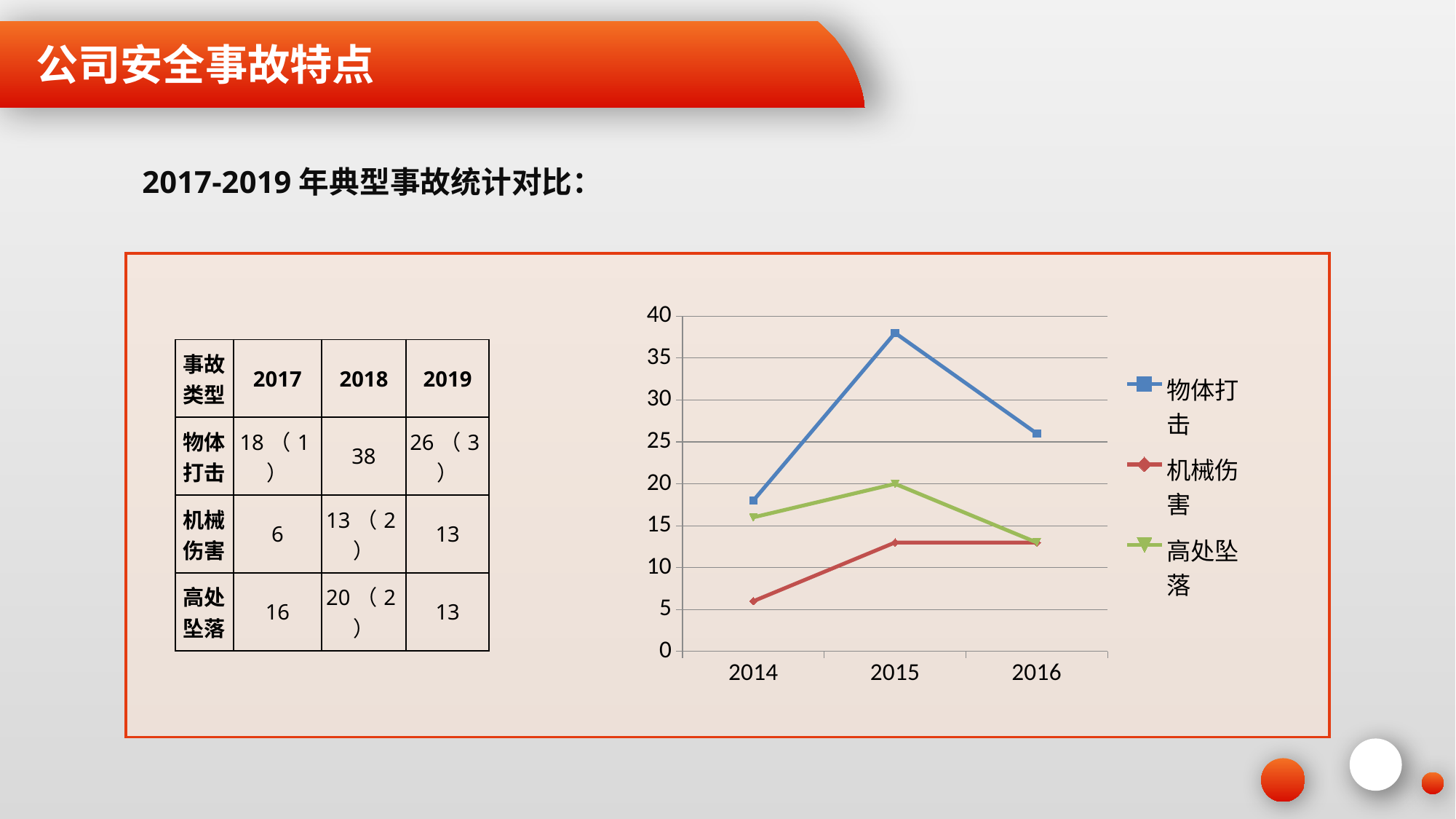
Is the value for 物体打击 in 2015 greater or less than 35? greater How many years are shown on the chart's x axis? 3 What kind of chart is shown on the slide? line chart How many series does the chart's legend list? 3 Which series has the lowest value in 2014? 机械伤害 Which series is drawn with the blue line in the chart? 物体打击 In which year does the 物体打击 series reach its highest value? 2015 Does the 物体打击 series rise or fall from 2015 to 2016? fall Is the value for 机械伤害 in 2014 greater or less than 10? less In which year is the 物体打击 series at its lowest value? 2014 In 2015, which series has the larger value, 物体打击 or 高处坠落? 物体打击 Is the value for 高处坠落 in 2016 greater or less than 15? less